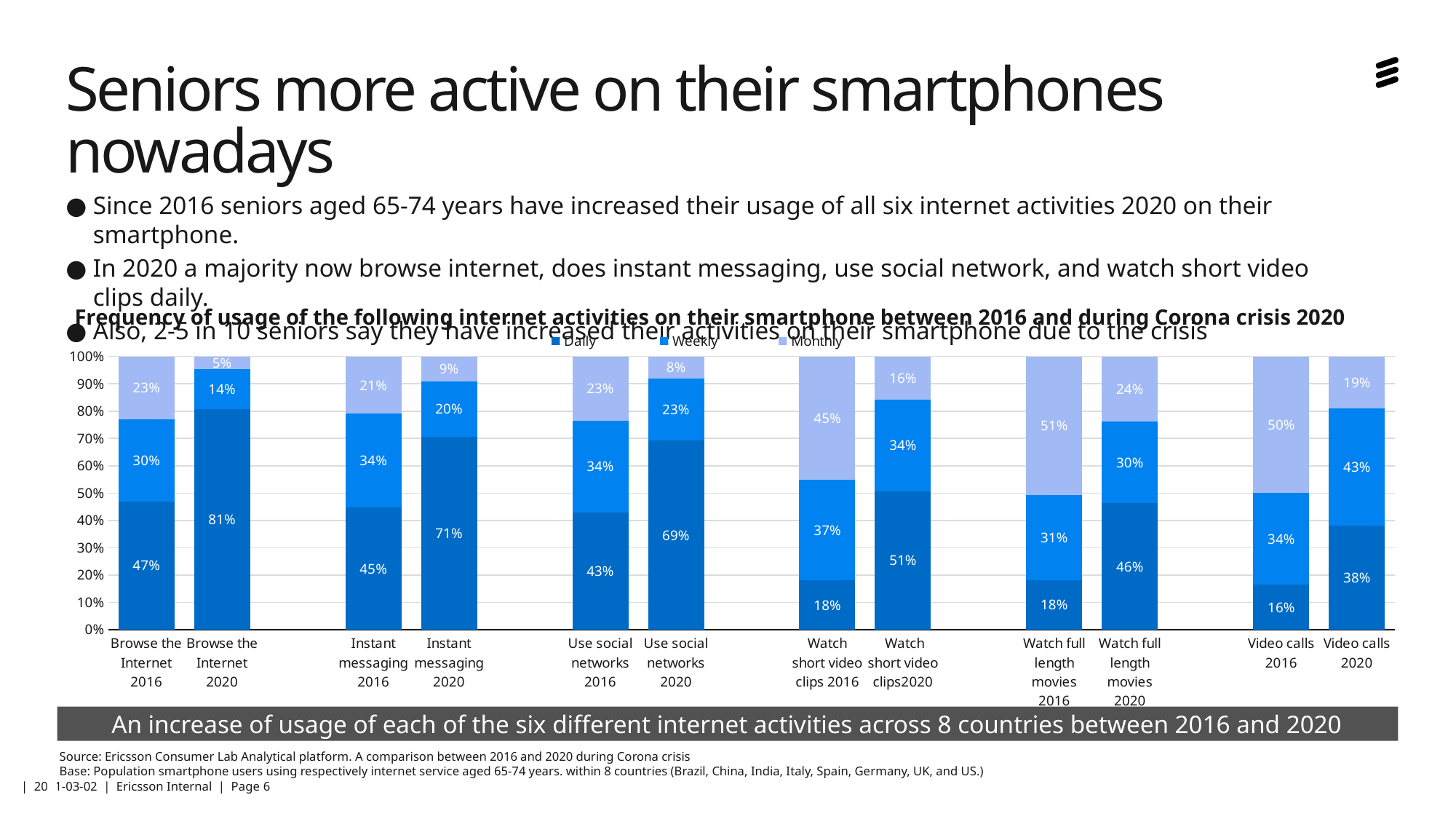
Which category has the lowest Daily value? Video calls 2016 How many series does the legend list? 3 Which is larger, the Daily value for Instant messaging 2020 or the Daily value for Use social networks 2020? Instant messaging 2020 What kind of chart is shown on the slide? Stacked bar chart What is the total of the stacked bar for Watch short video clips 2016? 100% What is the Daily value for Browse the Internet 2020? 81% Which category has the highest Daily value? Browse the Internet 2020 What is the Monthly value for Watch full length movies 2016? 51% How many categories are shown on the x axis? 12 What is the difference between the Daily value for Browse the Internet 2020 and Browse the Internet 2016? 34 percentage points What is the Weekly value for Video calls 2020? 43% What are the three series listed in the legend? Daily, Weekly, Monthly